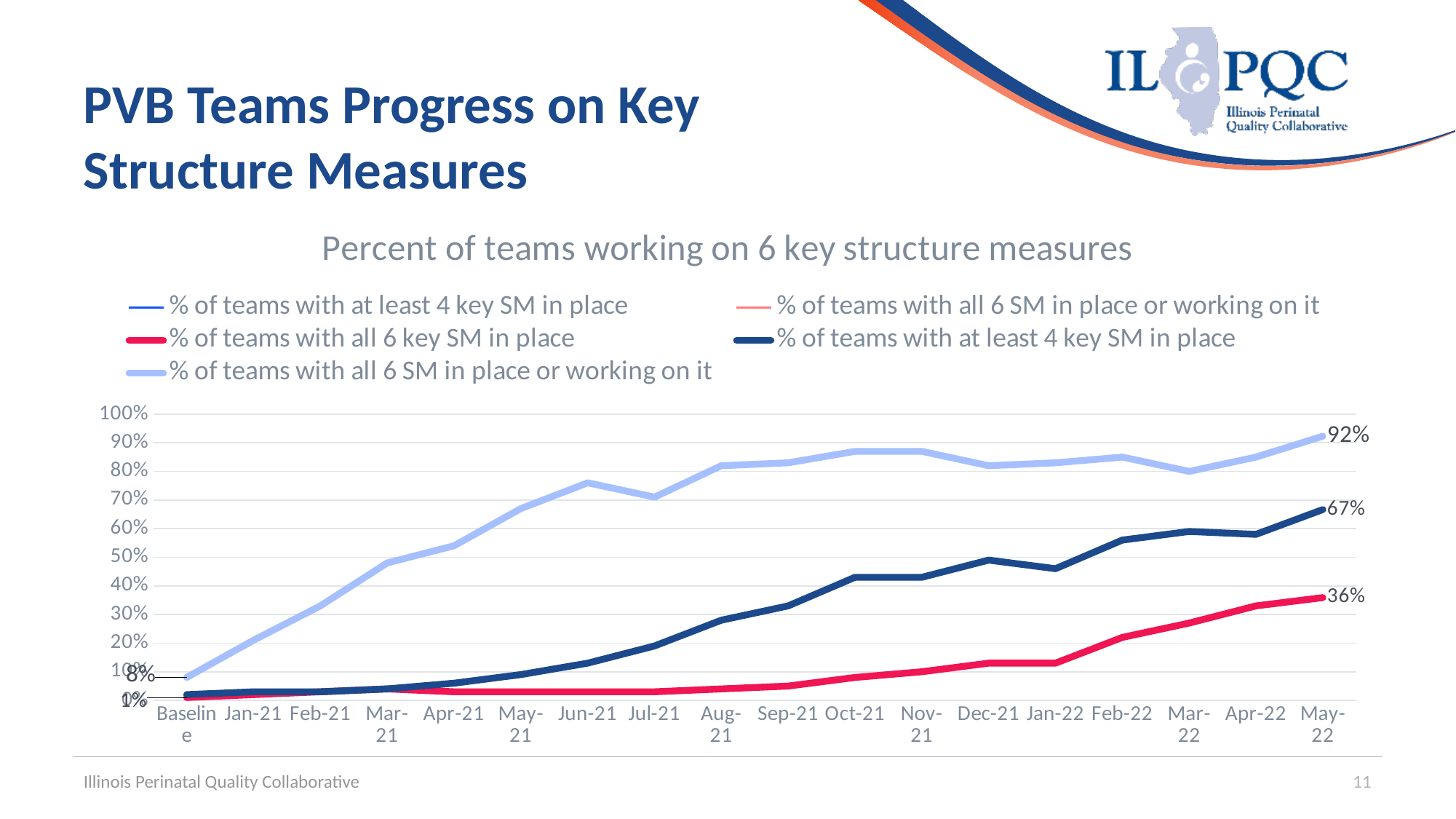
What kind of chart is shown on the slide? line chart What is the value for '% of teams with at least 4 key SM in place' at May-22? 67% At May-22, what is the difference between '% of teams with at least 4 key SM in place' and '% of teams with all 6 key SM in place'? 31 percentage points How many time points are shown on the x axis? 18 What is the value for '% of teams with all 6 key SM in place' at May-22? 36% Is the value for '% of teams with all 6 SM in place or working on it' at Oct-21 greater or less than 80%? greater Is the value for '% of teams with at least 4 key SM in place' at Jul-21 greater or less than 30%? less Which series has the highest value at May-22? % of teams with all 6 SM in place or working on it What is the value for '% of teams with all 6 SM in place or working on it' at Baseline? 8% What is the value for '% of teams with all 6 SM in place or working on it' at May-22? 92% What is the title of the chart? Percent of teams working on 6 key structure measures At May-22, what is the difference between '% of teams with all 6 SM in place or working on it' and '% of teams with at least 4 key SM in place'? 25 percentage points